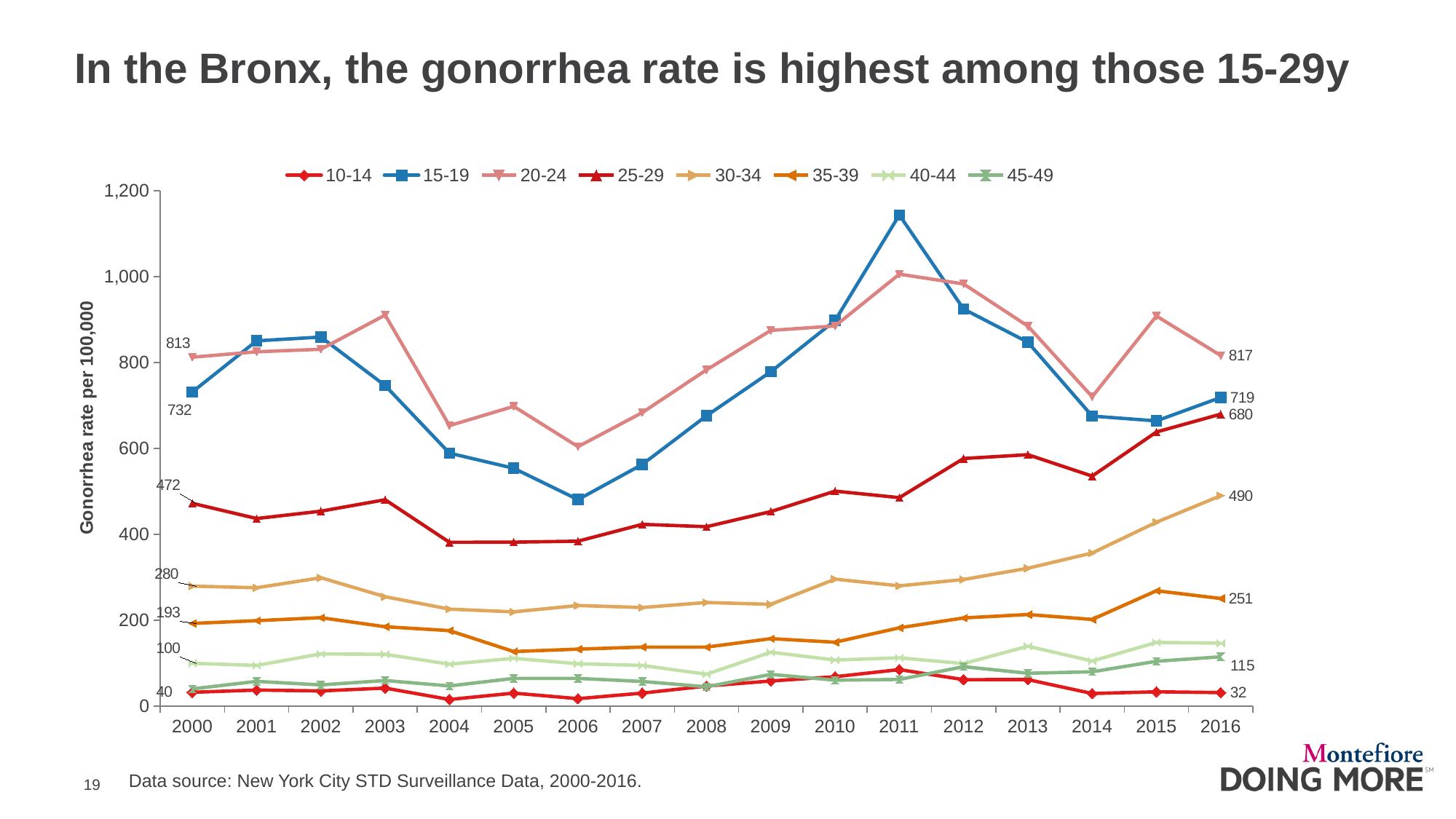
By how much did the 30-34 age group's rate change from 2000 (280) to 2016 (490)? 210 What was the gonorrhea rate for the 15-19 age group in 2016? 719 What kind of chart is shown on the slide? line chart Is the 15-19 group's rate in 2011 greater or less than 1,000? greater What is the label on the y axis? Gonorrhea rate per 100,000 What was the gonorrhea rate for the 30-34 age group in 2000? 280 What was the gonorrhea rate for the 35-39 age group in 2016? 251 How many age-group series does the legend list? 8 Which age group had the highest gonorrhea rate in 2011? 15-19 How many years are plotted along the x axis? 17 What was the gonorrhea rate for the 20-24 age group in 2000? 813 In 2016, which had the higher rate: the 15-19 group or the 25-29 group? 15-19